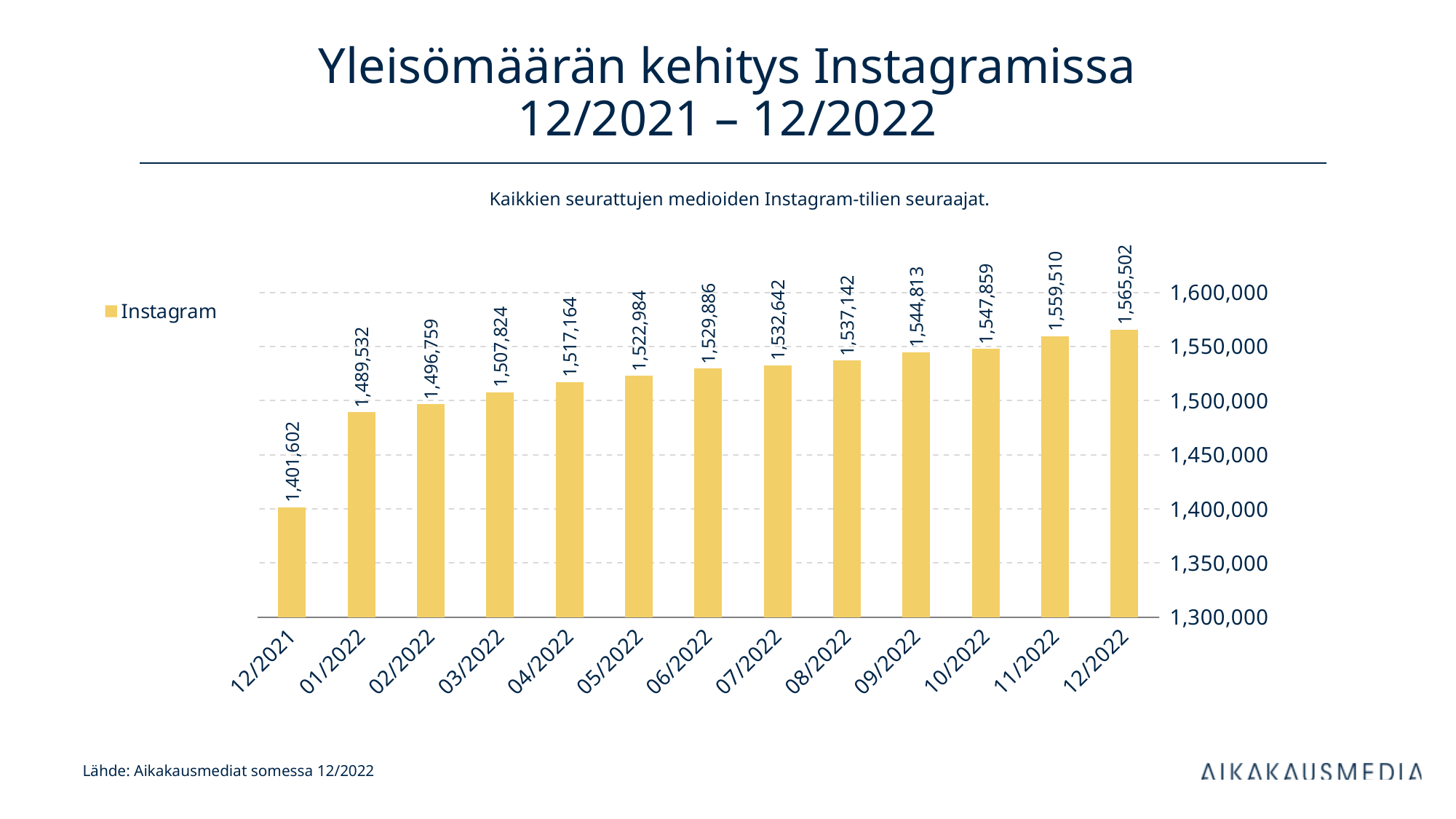
Is the value for 01/2022 greater or less than 1,500,000? less How many series does the legend list? 1 What kind of chart is shown? bar chart How many months are shown on the x axis? 13 What is the value for 12/2022? 1,565,502 What is the difference between the values for 12/2022 and 12/2021? 163,900 Do the values rise or fall from 12/2021 to 12/2022? rise Which is larger, the value for 03/2022 or the value for 09/2022? 09/2022 Which month has the highest value? 12/2022 What is the value for 12/2021? 1,401,602 What is the value for 06/2022? 1,529,886 Which month has the lowest value? 12/2021